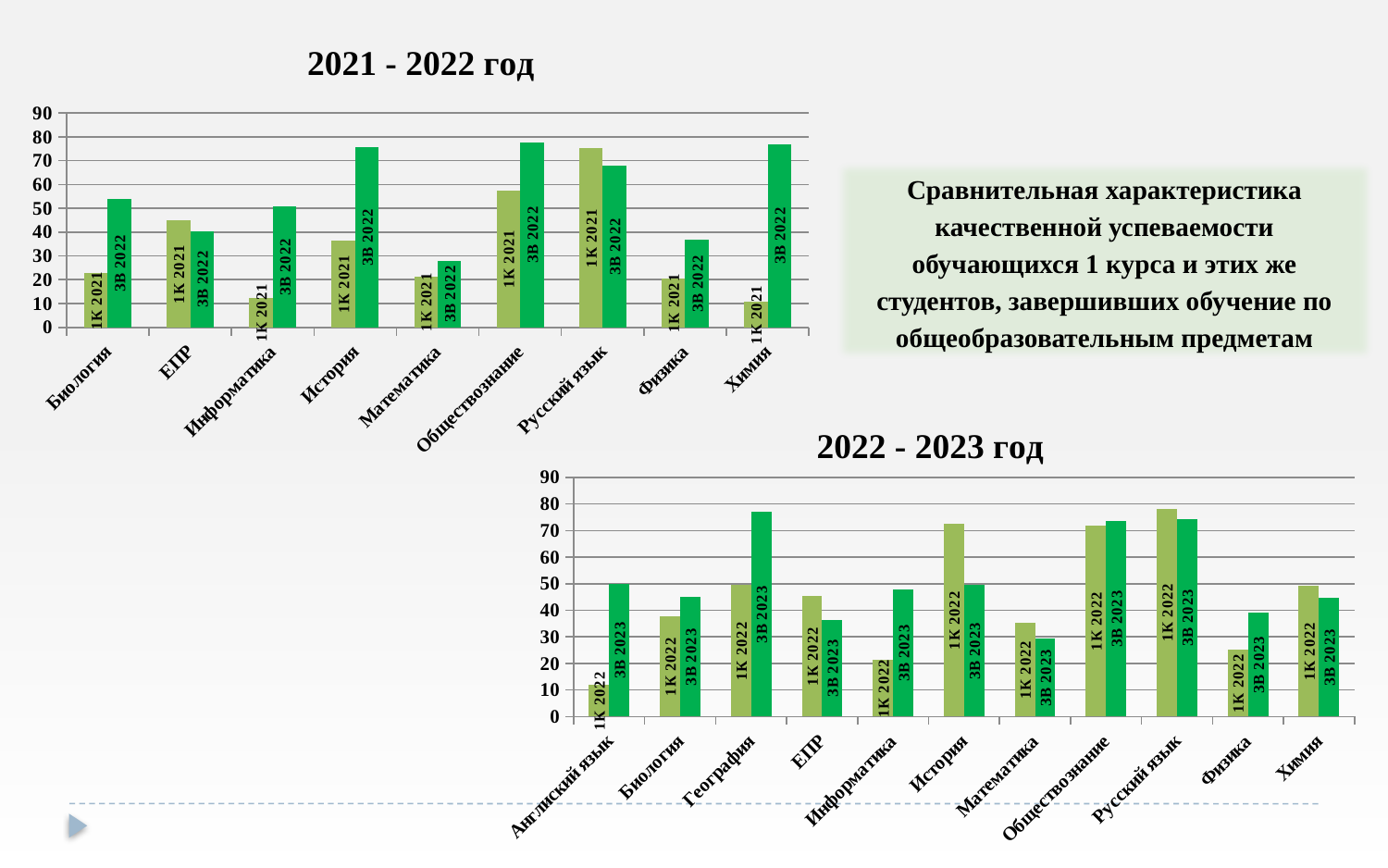
On the "2022 - 2023 год" chart, which subject has the lowest 1К 2022 value? Англиский язык On the "2021 - 2022 год" chart, is the ЗВ 2022 value for Биология greater or less than 50? greater How many subject categories are shown on the "2022 - 2023 год" chart? 11 How many series are plotted on the "2022 - 2023 год" chart? 2 On the "2021 - 2022 год" chart, is the ЗВ 2022 value for История greater or less than 70? greater How many subject categories are shown on the "2021 - 2022 год" chart? 9 On the "2021 - 2022 год" chart, is the 1К 2021 value for Химия greater or less than 20? less On the "2022 - 2023 год" chart, which subject has the highest 1К 2022 value? Русский язык On the "2022 - 2023 год" chart, which is larger for ЕПР: 1К 2022 or ЗВ 2023? 1К 2022 What kind of chart is the "2021 - 2022 год" chart? bar chart On the "2021 - 2022 год" chart, which is larger for Русский язык: 1К 2021 or ЗВ 2022? 1К 2021